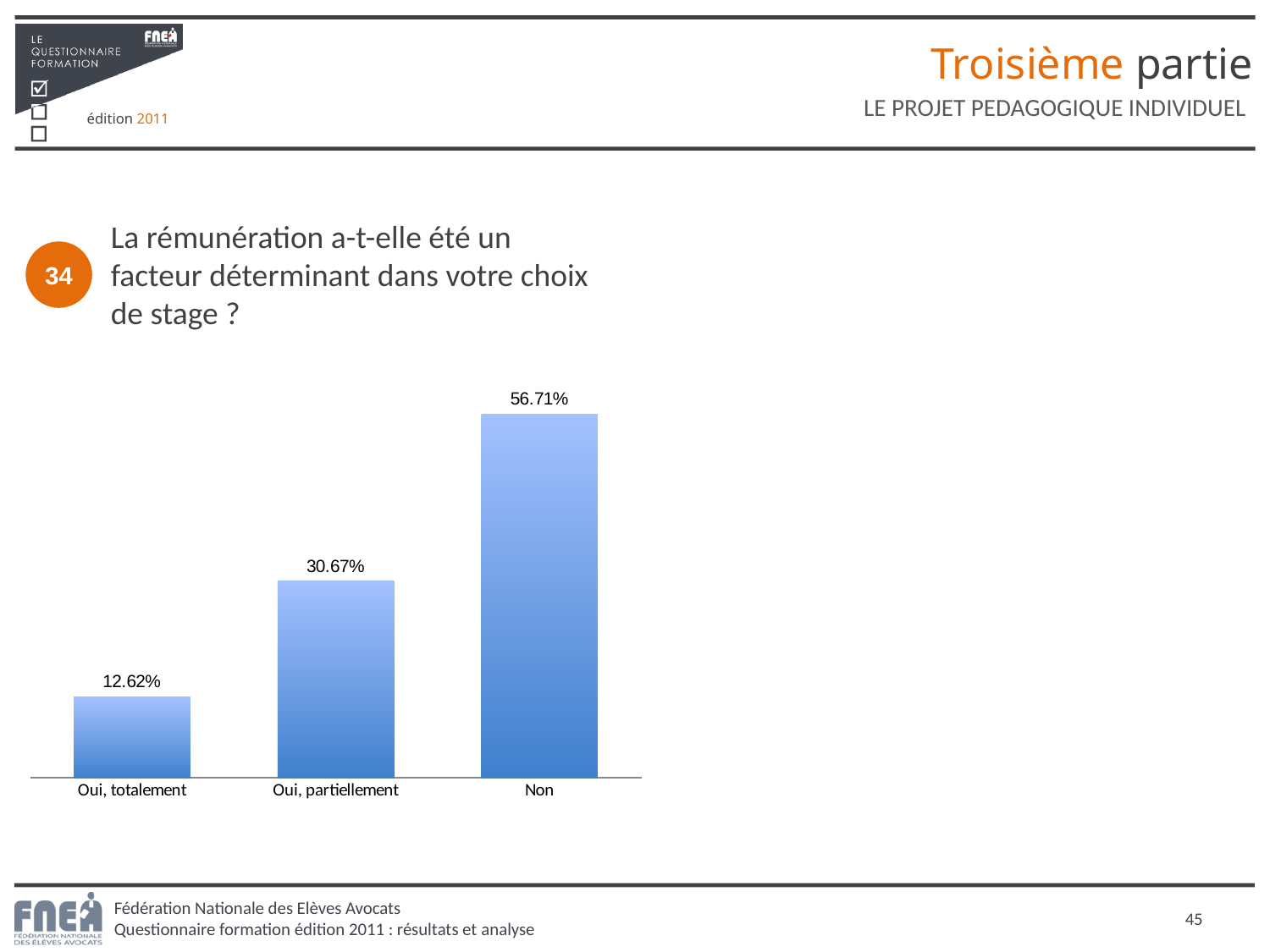
Do the values rise or fall from left to right across the categories? Rise What is the difference in percentage points between "Oui, partiellement" and "Oui, totalement"? 18.05 Which response category has the highest value? Non What percentage of respondents answered "Non"? 56.71% What is the value shown for "Oui, totalement"? 12.62% Which is larger: the value for "Oui, partiellement" or the value for "Oui, totalement"? Oui, partiellement What is the value shown for "Oui, partiellement"? 30.67% Which response category has the lowest value? Oui, totalement What is the combined percentage of the two "Oui" categories ("Oui, totalement" and "Oui, partiellement")? 43.29% What is the difference in percentage points between "Non" and "Oui, partiellement"? 26.04 What type of chart is shown on the slide? Bar chart How many response categories are shown in the chart? 3